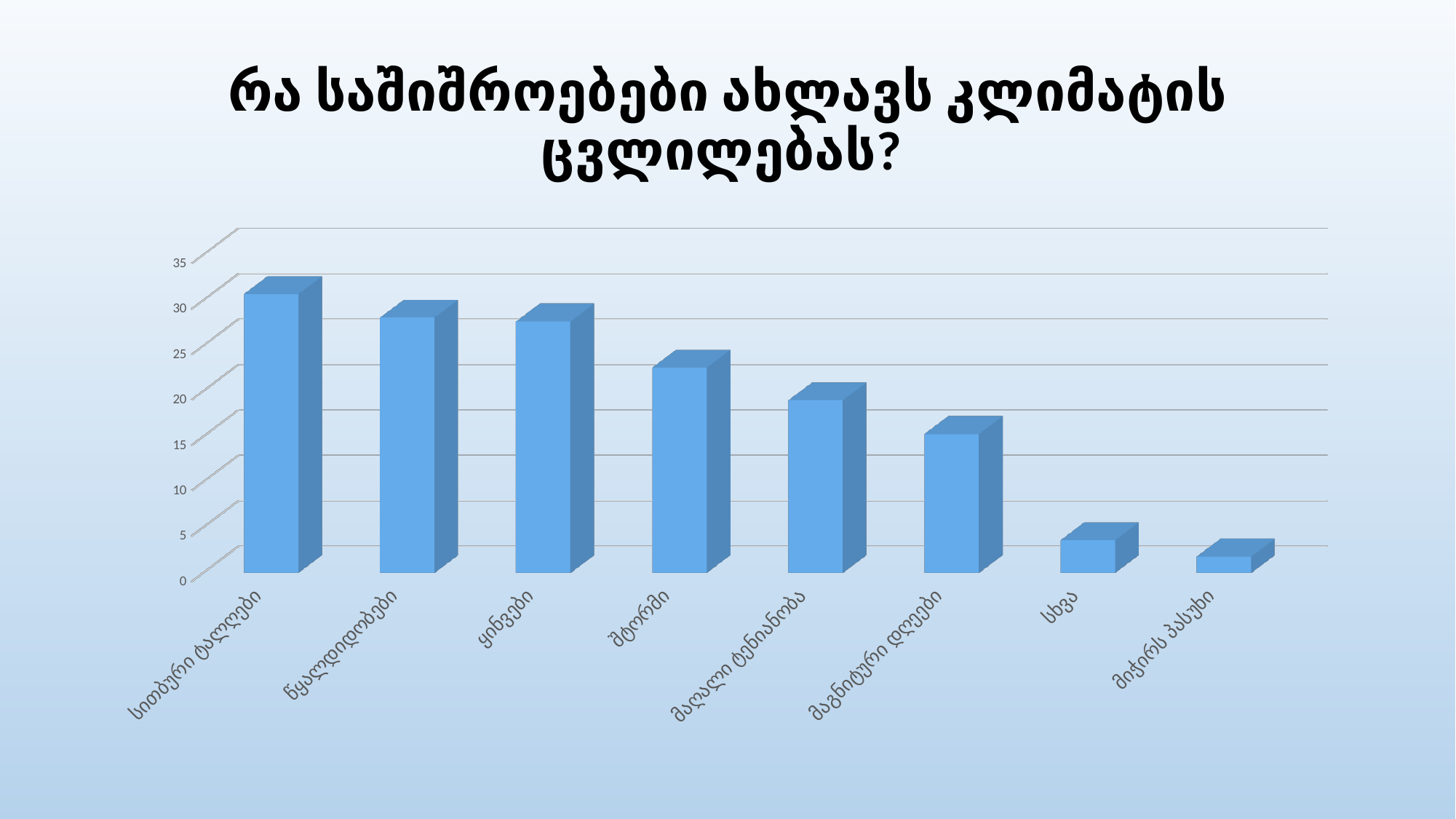
Is the value for მაღალი ტენიანობა greater or less than 15? greater Is the value for სითბური ტალღები greater or less than 25? greater Is the value for წყალდიდობები greater or less than 25? greater What kind of chart is shown on the slide? bar chart Do the values rise or fall from left to right along the x axis? fall Which category has the highest value? სითბური ტალღები Which category has the lowest value? მიჭირს პასუხი How many categories are plotted on the chart? 8 What is the title of the chart slide? რა საშიშროებები ახლავს კლიმატის ცვლილებას? Which is larger, the value for სითბური ტალღები or the value for შტორმი? სითბური ტალღები